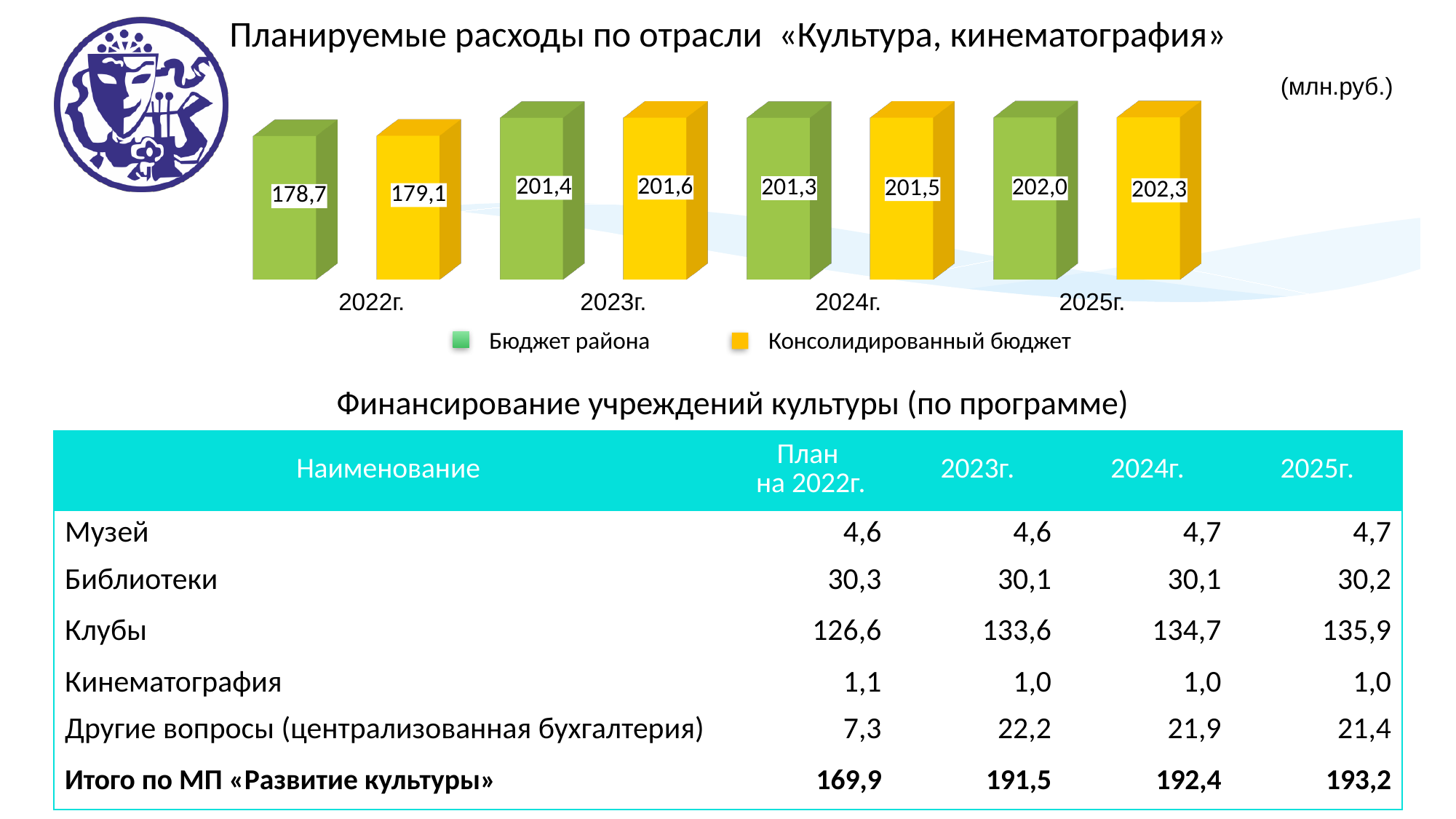
What is the value of Бюджет района for 2024г.? 201,3 What is the difference between Консолидированный бюджет and Бюджет района in 2022г.? 0,4 What is the value of Консолидированный бюджет for 2023г.? 201,6 In which year is Консолидированный бюджет the highest? 2025г. By how much does Бюджет района increase from 2022г. to 2023г.? 22,7 What type of chart is shown on the slide? Bar chart Which is larger in 2025г.: Бюджет района or Консолидированный бюджет? Консолидированный бюджет In which year is Бюджет района the lowest? 2022г. What is the value of Консолидированный бюджет for 2025г.? 202,3 How many series does the chart legend list? 2 How many years are shown on the x axis of the chart? 4 What is the value of Бюджет района for 2022г.? 178,7